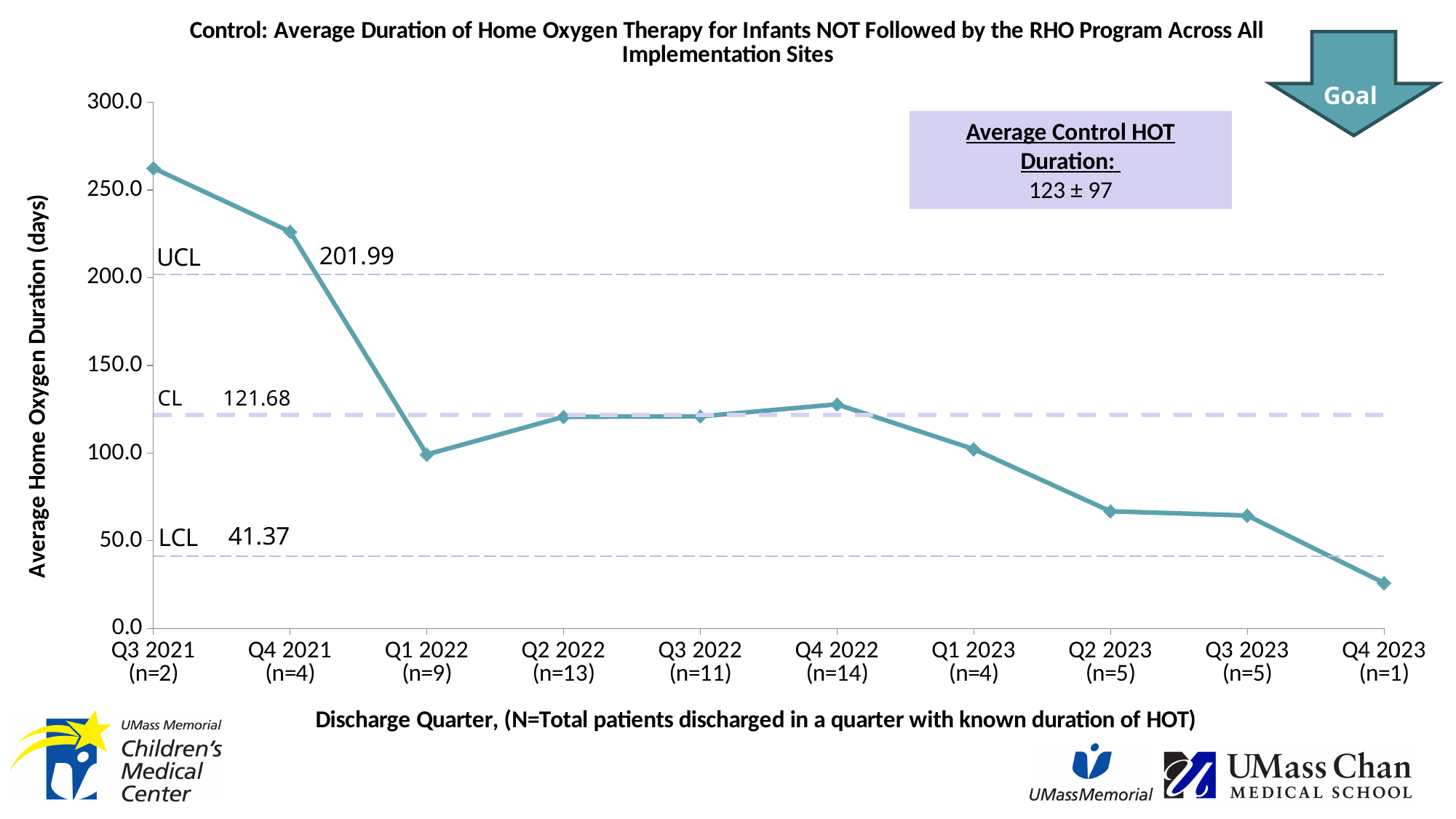
What is the Average Control HOT Duration stated in the box on the slide? 123 ± 97 Which discharge quarter has the lowest average home oxygen duration? Q4 2023 What is the difference between the UCL and the LCL values printed on the chart? 160.62 Is the value for Q3 2021 greater or less than 250? greater Which discharge quarter has the highest average home oxygen duration? Q3 2021 What is the value of the lower control limit (LCL) shown on the chart? 41.37 What kind of chart is shown on the slide? line chart Is the value for Q4 2023 greater or less than 50? less What is the value of the upper control limit (UCL) shown on the chart? 201.99 What is the value of the center line (CL) shown on the chart? 121.68 How many discharge quarters are plotted along the x axis? 10 Which is larger, the value for Q1 2023 or the value for Q2 2023? Q1 2023